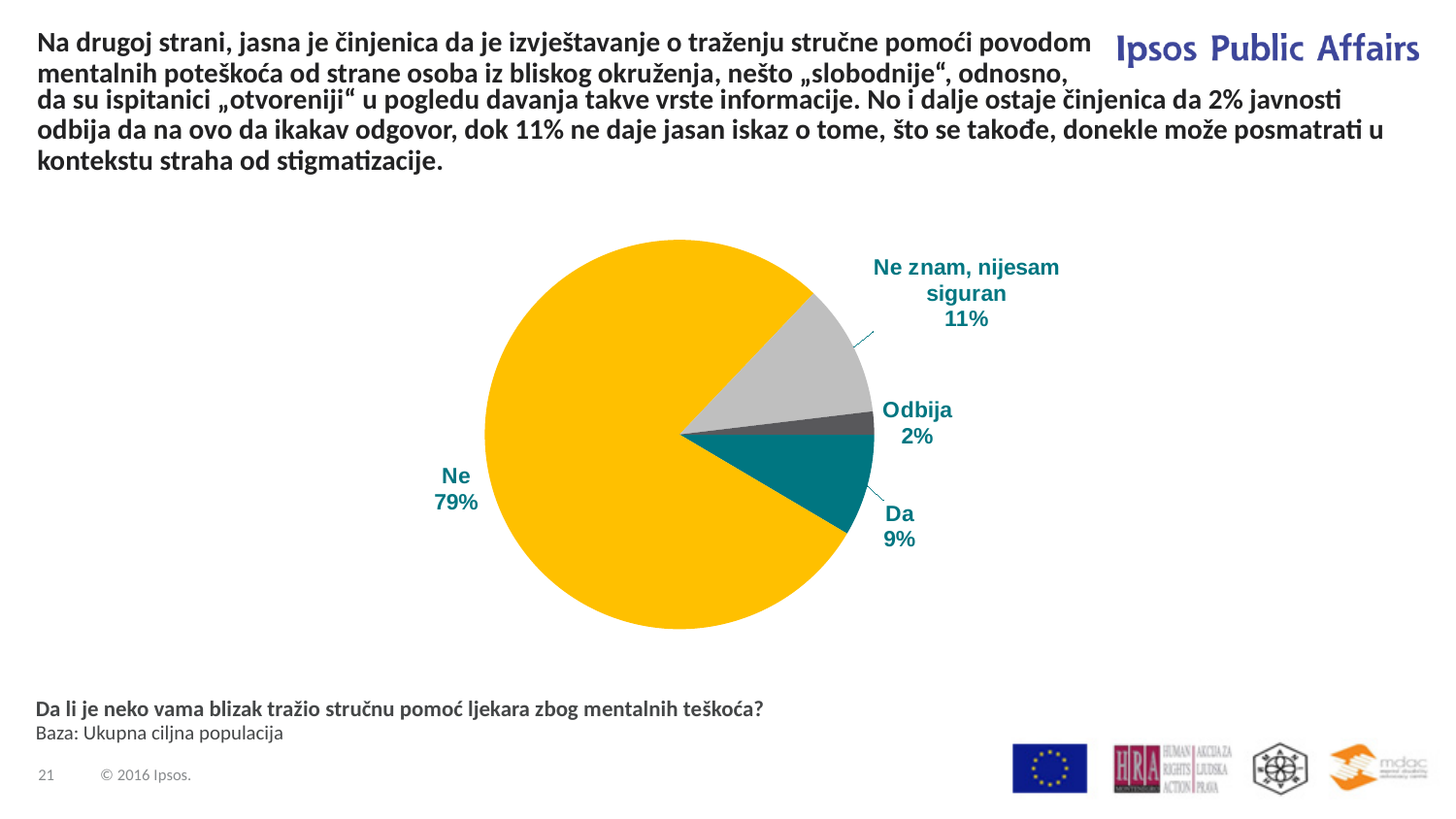
What percentage of respondents answered "Odbija"? 2% Which is larger, the share for "Da" or the share for "Ne znam, nijesam siguran"? Ne znam, nijesam siguran What percentage of respondents answered "Da"? 9% What colour is the "Ne" slice of the pie? yellow What is the difference in percentage points between "Ne" and "Da"? 70 What percentage of respondents answered "Ne znam, nijesam siguran"? 11% How many slices does the pie chart have? 4 What is the combined share of "Da" and "Odbija"? 11% What percentage of respondents answered "Ne"? 79% What kind of chart is shown on the slide? pie chart Which category has the smallest share of the pie? Odbija Which category has the largest share of the pie? Ne